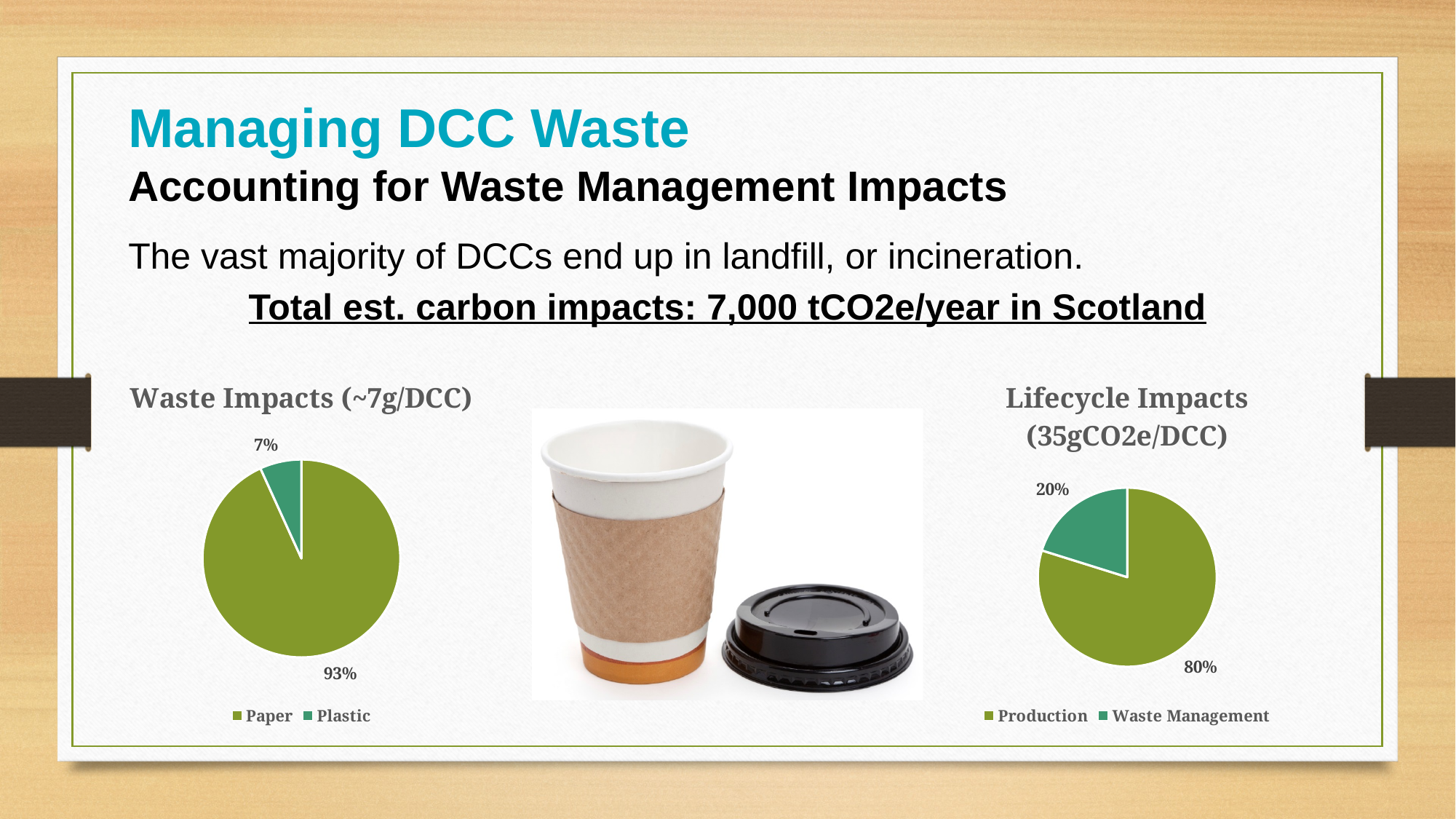
In the 'Waste Impacts (~7g/DCC)' chart, what share does Plastic have? 7% What are the legend entries of the 'Waste Impacts (~7g/DCC)' chart? Paper, Plastic In the 'Waste Impacts (~7g/DCC)' chart, which category has the largest slice? Paper How many categories does the 'Lifecycle Impacts (35gCO2e/DCC)' chart show? 2 What type of chart is the 'Waste Impacts (~7g/DCC)' chart? Pie chart In the 'Lifecycle Impacts (35gCO2e/DCC)' chart, what share does Production have? 80% In the 'Lifecycle Impacts (35gCO2e/DCC)' chart, what is the difference between the Production and Waste Management shares? 60% In the 'Waste Impacts (~7g/DCC)' chart, what share does Paper have? 93% In the 'Waste Impacts (~7g/DCC)' chart, what is the difference between the Paper and Plastic shares? 86% In the 'Lifecycle Impacts (35gCO2e/DCC)' chart, which category has the smallest slice? Waste Management In the 'Lifecycle Impacts (35gCO2e/DCC)' chart, what share does Waste Management have? 20% In the 'Lifecycle Impacts (35gCO2e/DCC)' chart, which is larger, Production or Waste Management? Production